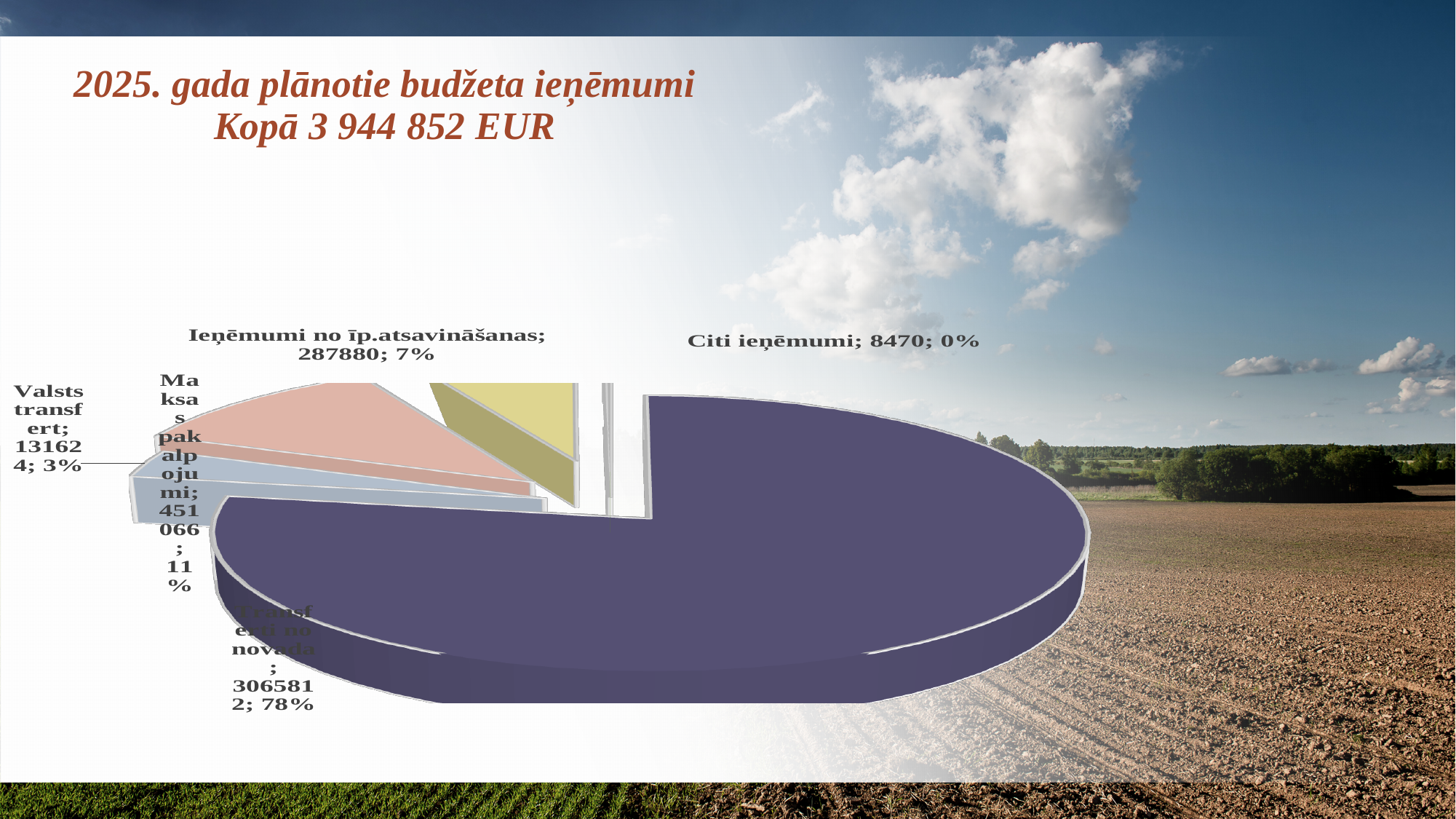
Which category has the largest slice of the pie? Transferti no novada What is the value for Maksas pakalpojumi? 451066 What is the value for Ieņēmumi no īp.atsavināšanas? 287880 What is the value for Valsts transfert? 131624 Which category has the smallest slice of the pie? Citi ieņēmumi What share of the pie does Maksas pakalpojumi represent? 11% What is the value for Transferti no novada? 3065812 What is the value for Citi ieņēmumi? 8470 What kind of chart is shown on the slide? pie chart How many slices does the pie chart have? 5 Which is larger, Ieņēmumi no īp.atsavināšanas or Valsts transfert? Ieņēmumi no īp.atsavināšanas What is the difference between the values for Maksas pakalpojumi and Ieņēmumi no īp.atsavināšanas? 163186